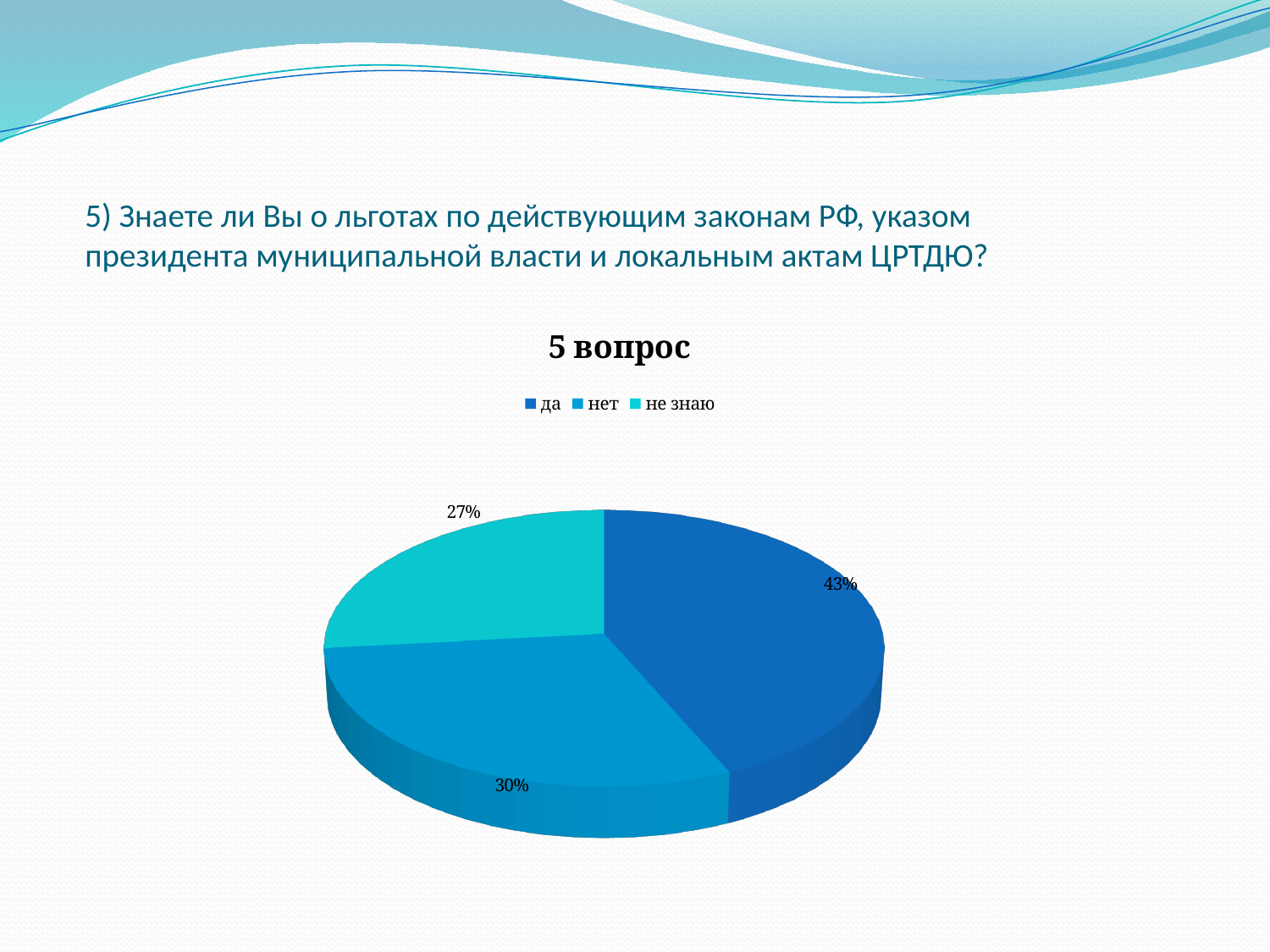
What percentage of the pie is the 'нет' slice? 30% Which is larger, the 'нет' slice or the 'не знаю' slice? нет Which answer has the largest share of the pie? да What kind of chart is shown on the slide? pie chart What is the difference in percentage points between the 'да' and 'нет' slices? 13 Which answer has the smallest share of the pie? не знаю What is the title of the chart? 5 вопрос What are the legend entries of the chart, in order? да, нет, не знаю What percentage of the pie is the 'да' slice? 43% What percentage of the pie is the 'не знаю' slice? 27% How many entries does the legend list? 3 How many slices does the pie chart have? 3